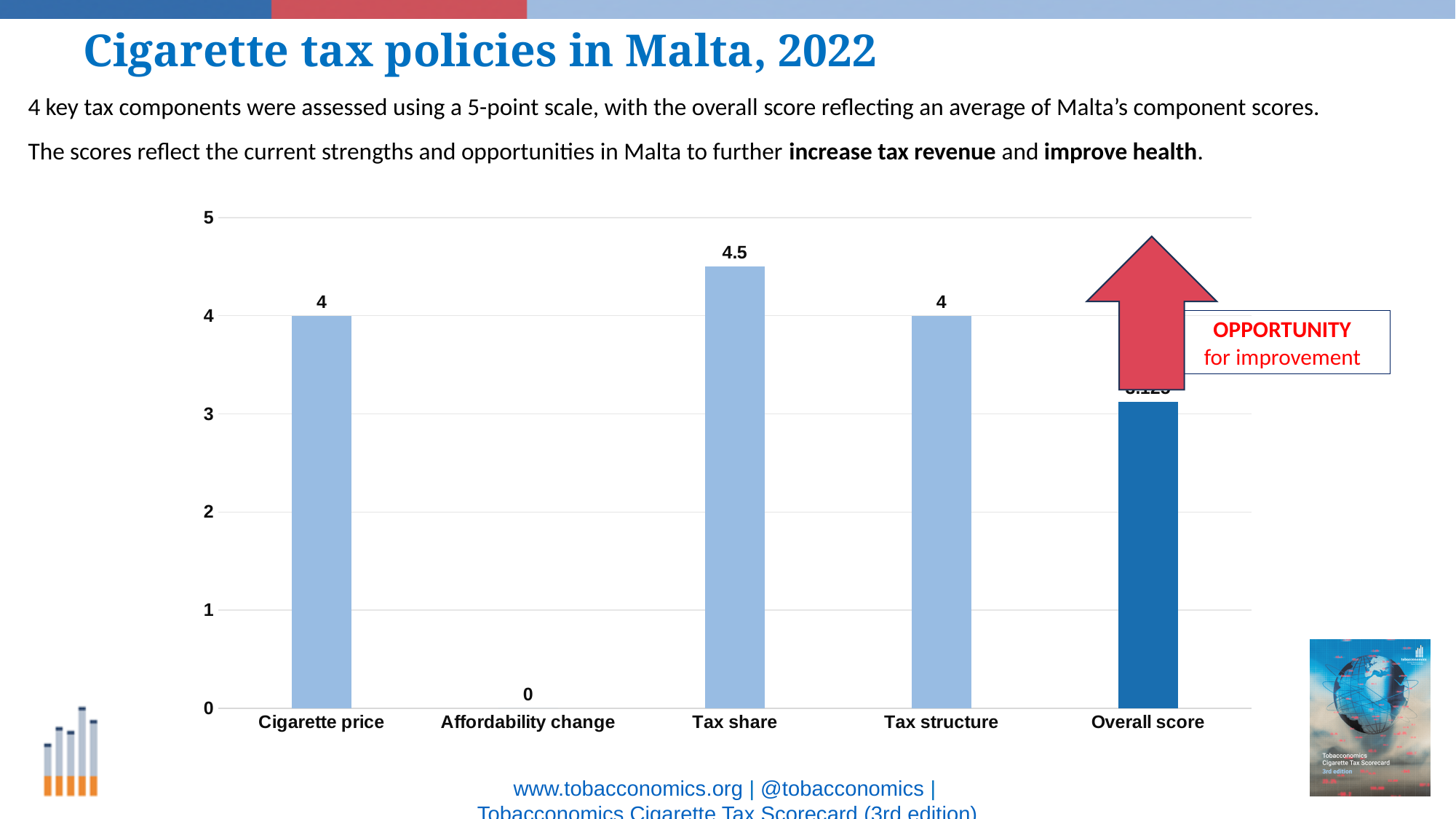
Which is larger, the value for Tax share or the value for Tax structure? Tax share What kind of chart is shown on the slide? bar chart What is the difference between the values for Tax share and Cigarette price? 0.5 Which category has the highest value? Tax share What is the value for Tax structure? 4 Is the value for Overall score greater or less than 4? less What is the value for Tax share? 4.5 Which bar is drawn in a darker blue than the others? Overall score How many categories are shown on the x axis? 5 What is the value for Affordability change? 0 Which category has the lowest value? Affordability change What is the value for Cigarette price? 4